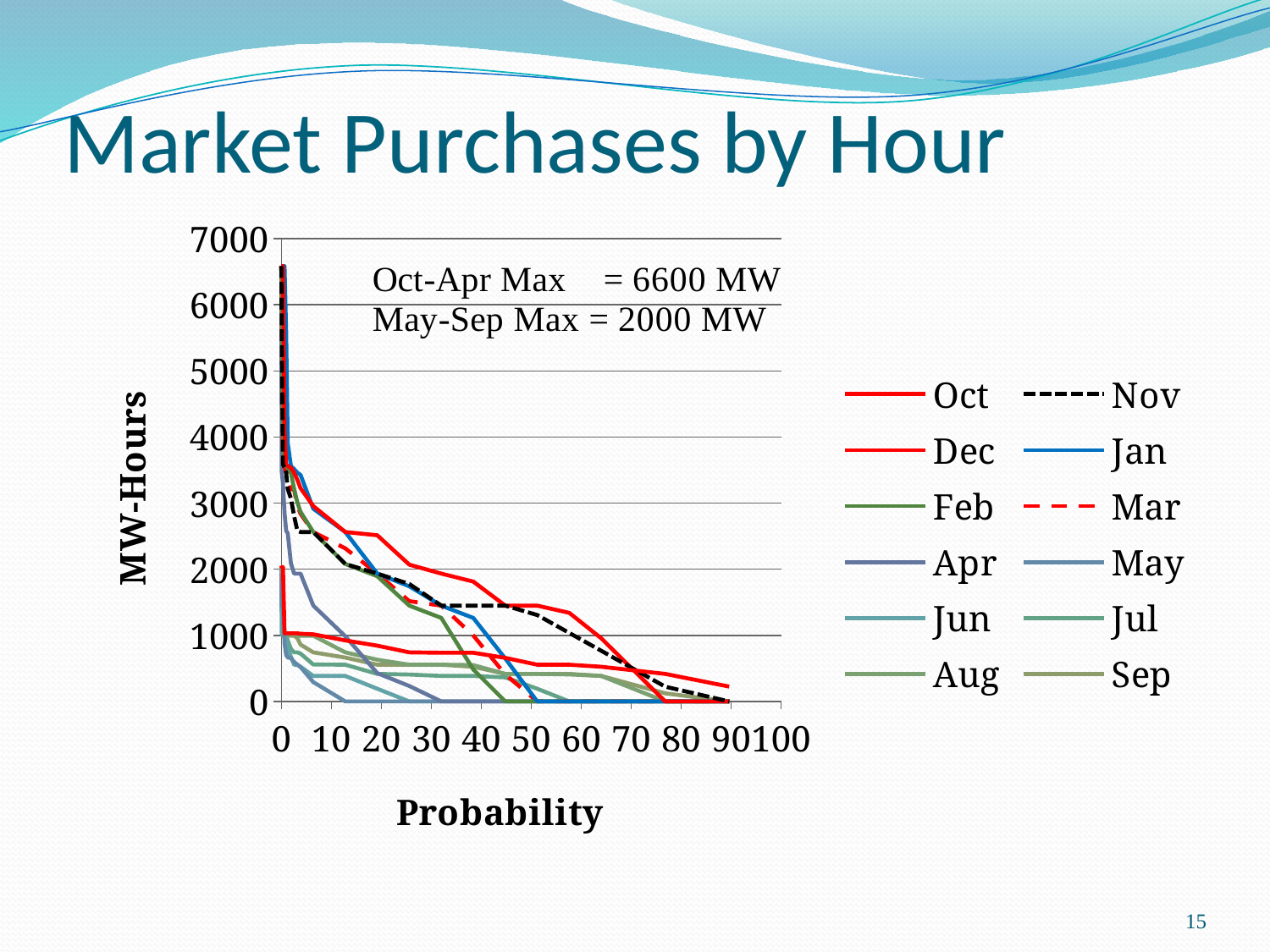
Is the value for Oct at a probability of 80 greater or less than 1000? less Is the value for Jan at a probability of 30 greater or less than 1000? greater What is the label on the vertical axis of the chart? MW-Hours According to the annotation on the chart, what is the May-Sep maximum? 2000 MW What kind of chart is shown on the slide? line chart Which two series in the legend are drawn with dashed lines? Nov and Mar Is the value for Nov at a probability of 40 greater or less than 1000? greater According to the annotation on the chart, what is the Oct-Apr maximum? 6600 MW Do the plotted values rise or fall as probability increases along the x axis? fall How many series does the legend list? 12